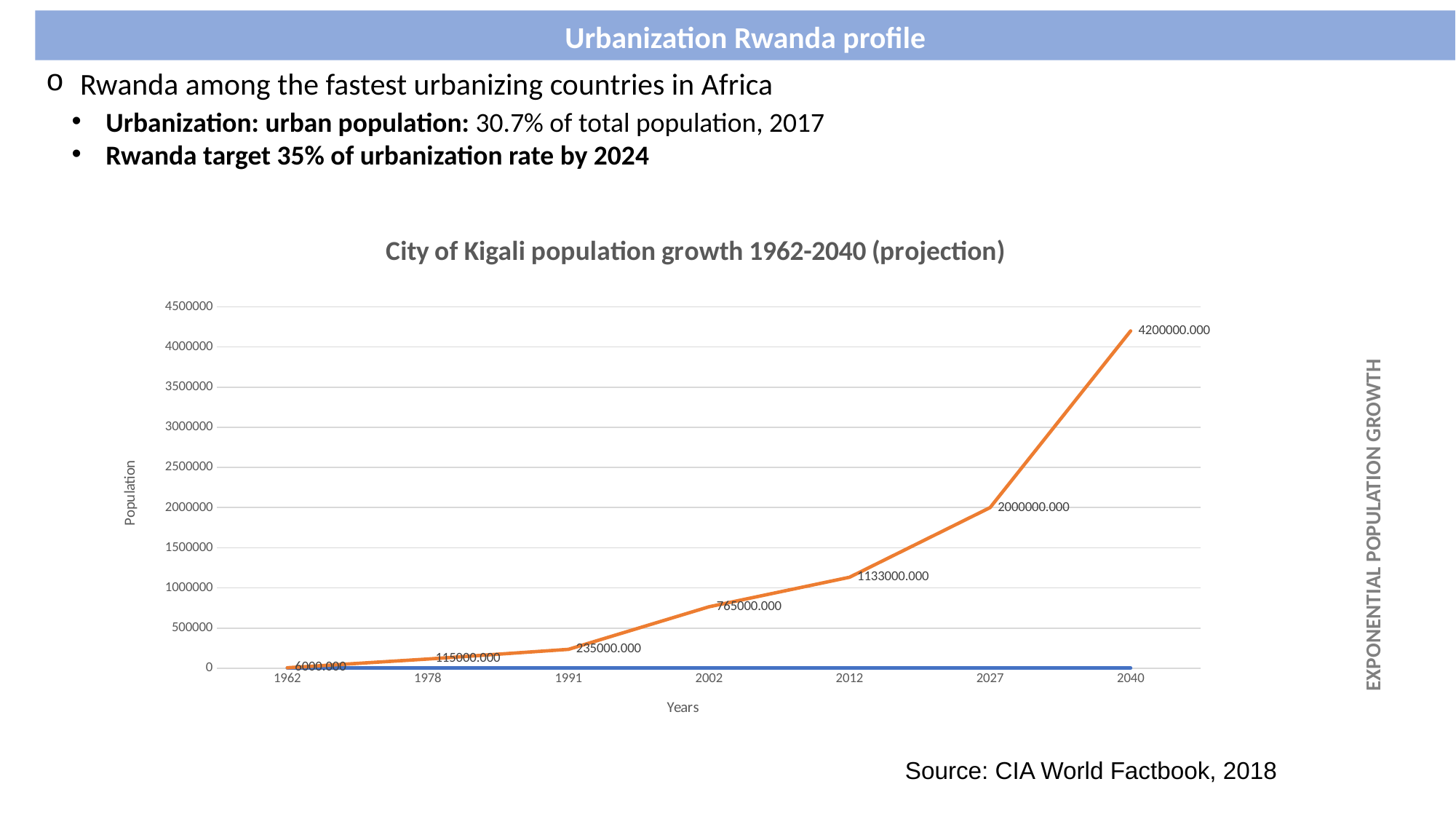
Which year has the lowest population value in the City of Kigali population growth chart? 1962 What is the difference between the population values for 2040 and 2027 in the City of Kigali population growth chart? 2200000.000 Which year has the highest population value in the City of Kigali population growth chart? 2040 What is the population value shown for 1962 in the City of Kigali population growth chart? 6000.000 What is the population value shown for 2002 in the City of Kigali population growth chart? 765000.000 What is the population value shown for 2040 in the City of Kigali population growth chart? 4200000.000 What kind of chart is the City of Kigali population growth chart? line chart How many years are shown on the x axis of the City of Kigali population growth chart? 7 Which year has a larger population value in the City of Kigali population growth chart, 1991 or 2002? 2002 What is the population value shown for 2012 in the City of Kigali population growth chart? 1133000.000 Does the population in the City of Kigali population growth chart rise or fall from 1962 to 2040? rise Is the population value for 2012 in the City of Kigali population growth chart greater or less than 1000000? greater